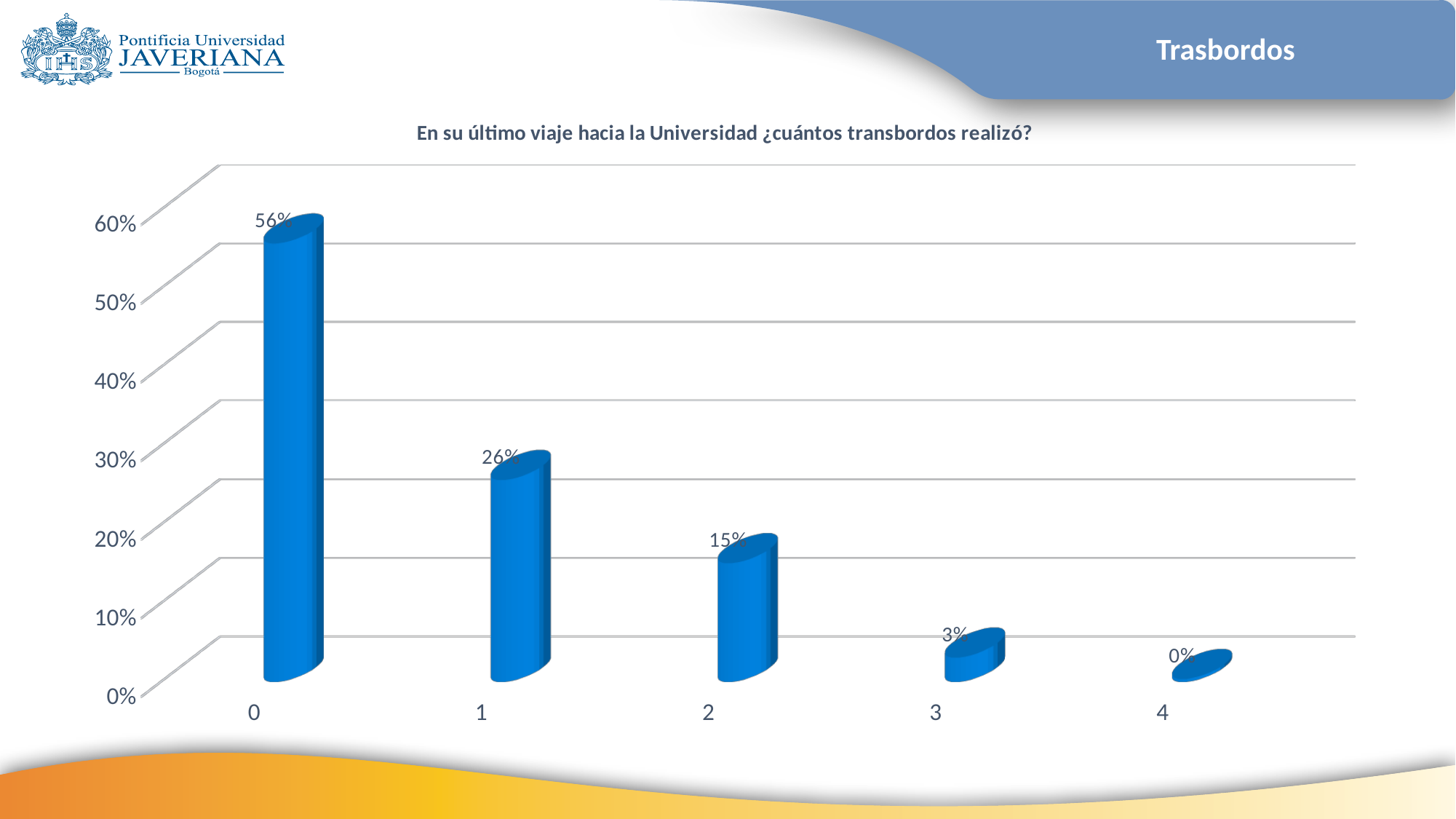
What percentage is shown for 2 transfers? 15% Do the values rise or fall as you move from category 0 to category 4 along the x axis? Fall Which category has the highest value in the chart? 0 What is the difference between the values for 0 transfers and 1 transfer? 30% Which category has the lowest value in the chart? 4 What is the value shown for category 4? 0% What is the value shown for category 3? 3% How many categories are shown on the x axis of the chart? 5 What percentage of respondents made 0 transfers (transbordos) on their last trip to the university? 56% What kind of chart is shown on the slide? Bar chart What is the value shown for category 1 in the chart? 26% Which is larger, the value for 2 transfers or the value for 3 transfers? 2 transfers